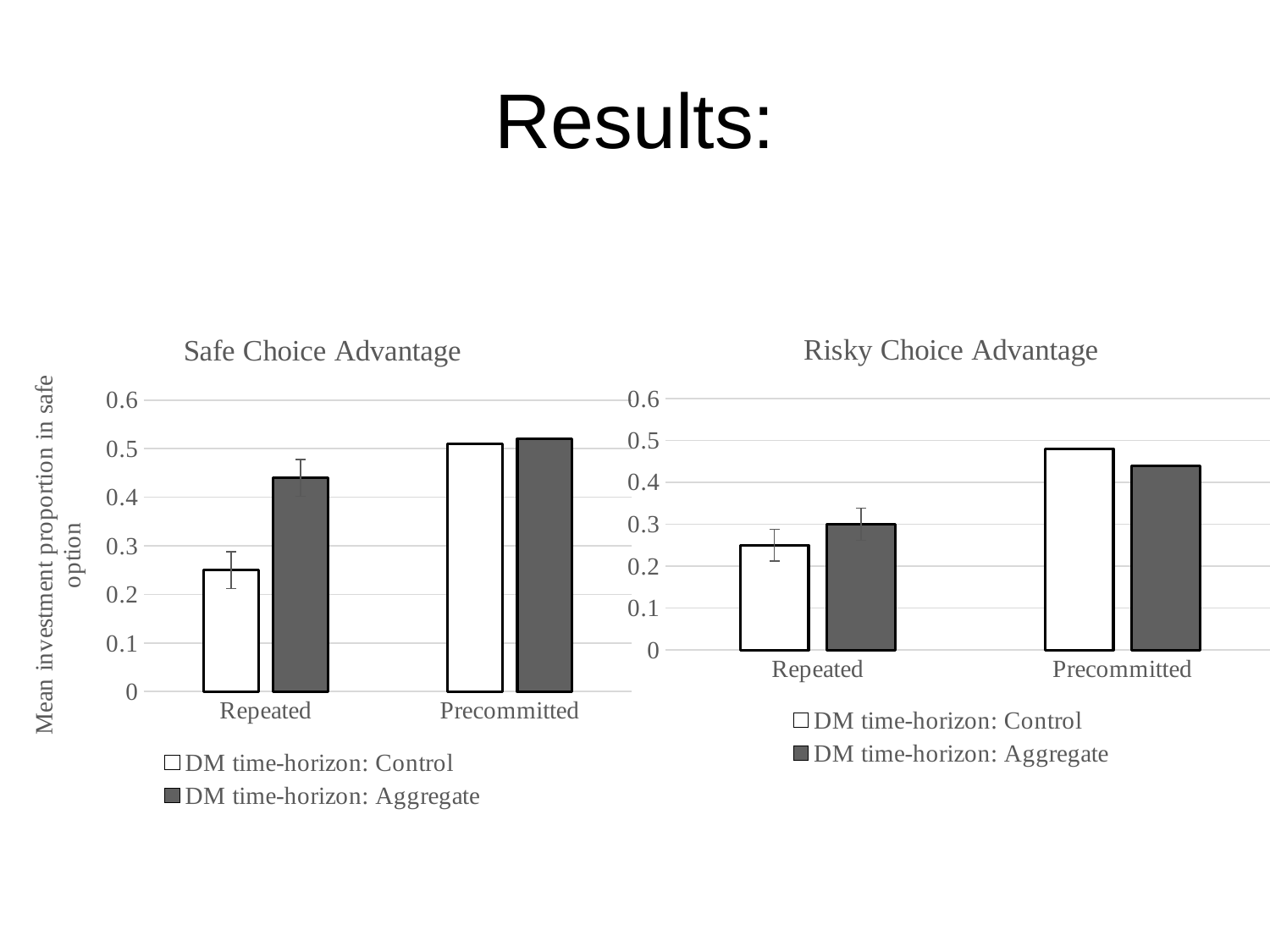
How many categories are shown on the x axis of the Safe Choice Advantage chart? 2 In the Risky Choice Advantage chart, is the value for DM time-horizon: Control in the Precommitted condition greater or less than 0.4? greater In the Safe Choice Advantage chart, is the value for DM time-horizon: Control in the Repeated condition greater or less than 0.3? less What is the y-axis title of the Safe Choice Advantage chart? Mean investment proportion in safe option What kind of chart is the Safe Choice Advantage chart? bar chart In the Risky Choice Advantage chart, which series has the larger value in the Precommitted condition, DM time-horizon: Control or DM time-horizon: Aggregate? DM time-horizon: Control In the Risky Choice Advantage chart, is the value for DM time-horizon: Aggregate in the Precommitted condition greater or less than 0.5? less In the Safe Choice Advantage chart, which series has the larger value in the Repeated condition, DM time-horizon: Control or DM time-horizon: Aggregate? DM time-horizon: Aggregate In the Safe Choice Advantage chart, which bar is the lowest? DM time-horizon: Control, Repeated In the Risky Choice Advantage chart, which bar is the highest? DM time-horizon: Control, Precommitted How many series does the legend of the Risky Choice Advantage chart list? 2